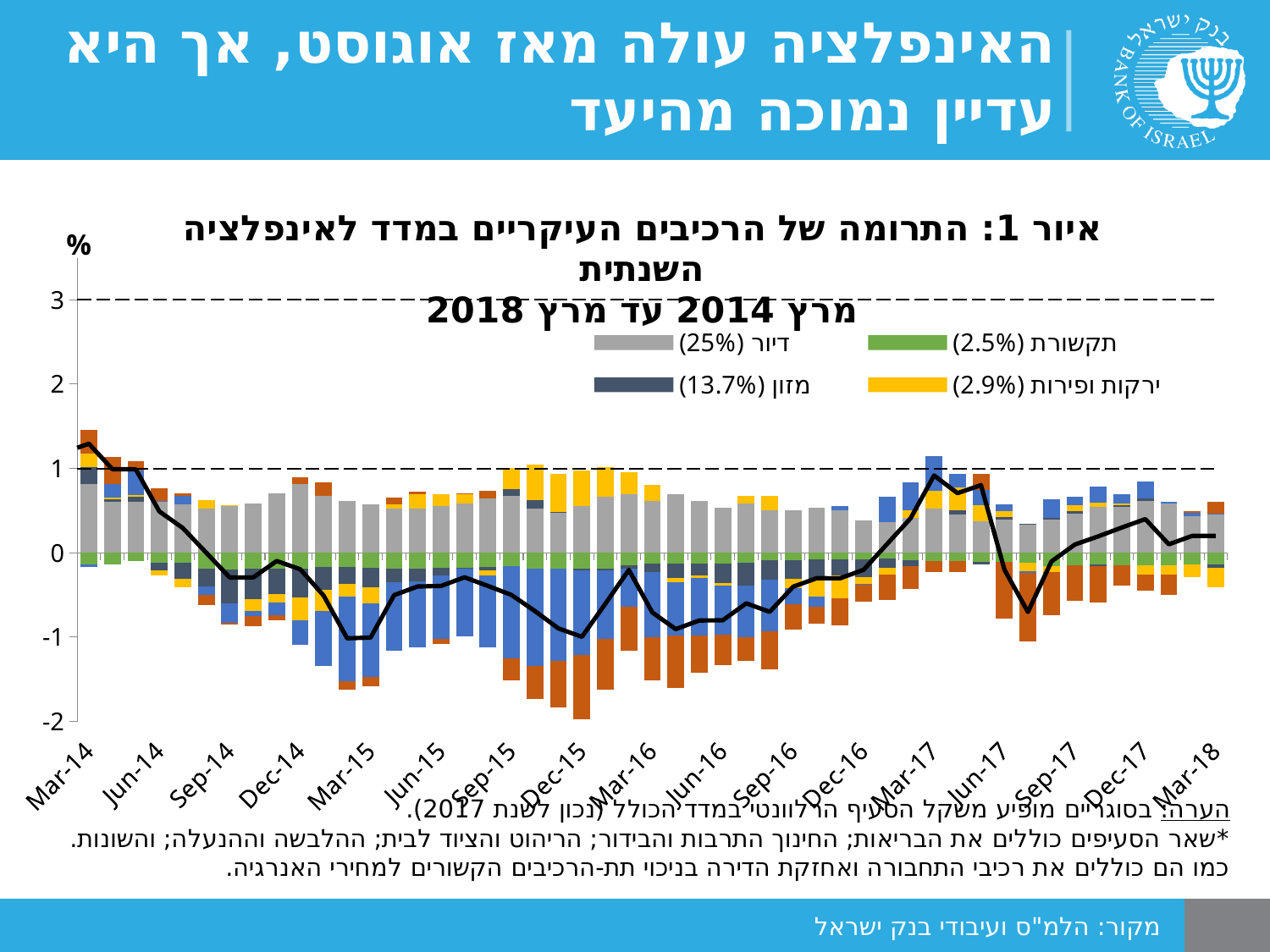
How many date labels are shown along the x axis? 17 What weight is shown in the legend for דיור? 25% How many series does the legend list? 4 Which is higher, the black line at Mar-14 or at Mar-17? Mar-14 Does the black line rise or fall between Mar-14 and Sep-14? fall Is the value of the black line at Mar-17 greater or less than 0.5? greater What kind of chart is shown on the slide? Stacked bar chart with a line At which x-axis date does the black line reach its highest value? Mar-14 Is the value of the black line at Mar-14 greater or less than 1? greater What unit is shown at the top of the y axis? % Is the value of the black line at Mar-18 greater or less than 0? greater